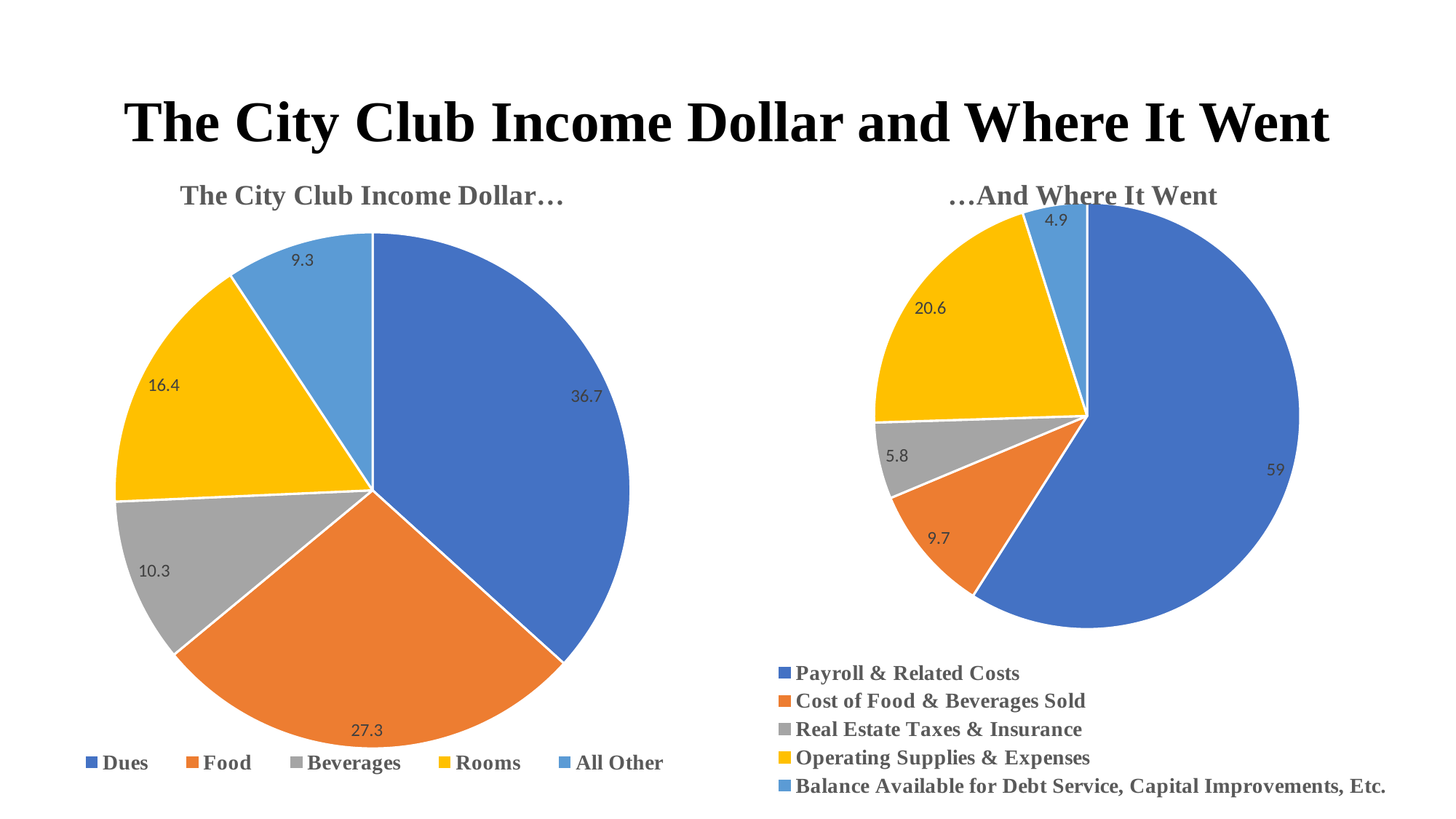
In the chart titled "The City Club Income Dollar…", how many categories are shown? 5 In the chart titled "…And Where It Went", what is the difference between Operating Supplies & Expenses and Balance Available for Debt Service, Capital Improvements, Etc.? 15.7 In the chart titled "The City Club Income Dollar…", what is the value for Rooms? 16.4 In the chart titled "…And Where It Went", what is the value for Operating Supplies & Expenses? 20.6 In the chart titled "The City Club Income Dollar…", what colour is the Rooms slice? Yellow In the chart titled "The City Club Income Dollar…", which category has the smallest slice? All Other In the chart titled "…And Where It Went", which category has the largest slice? Payroll & Related Costs In the chart titled "The City Club Income Dollar…", what is the value for Dues? 36.7 In the chart titled "…And Where It Went", which is larger: Cost of Food & Beverages Sold or Real Estate Taxes & Insurance? Cost of Food & Beverages Sold What type of chart is the chart titled "…And Where It Went"? Pie chart In the chart titled "…And Where It Went", what is the value for Payroll & Related Costs? 59 In the chart titled "The City Club Income Dollar…", what is the difference between the Food and Beverages values? 17